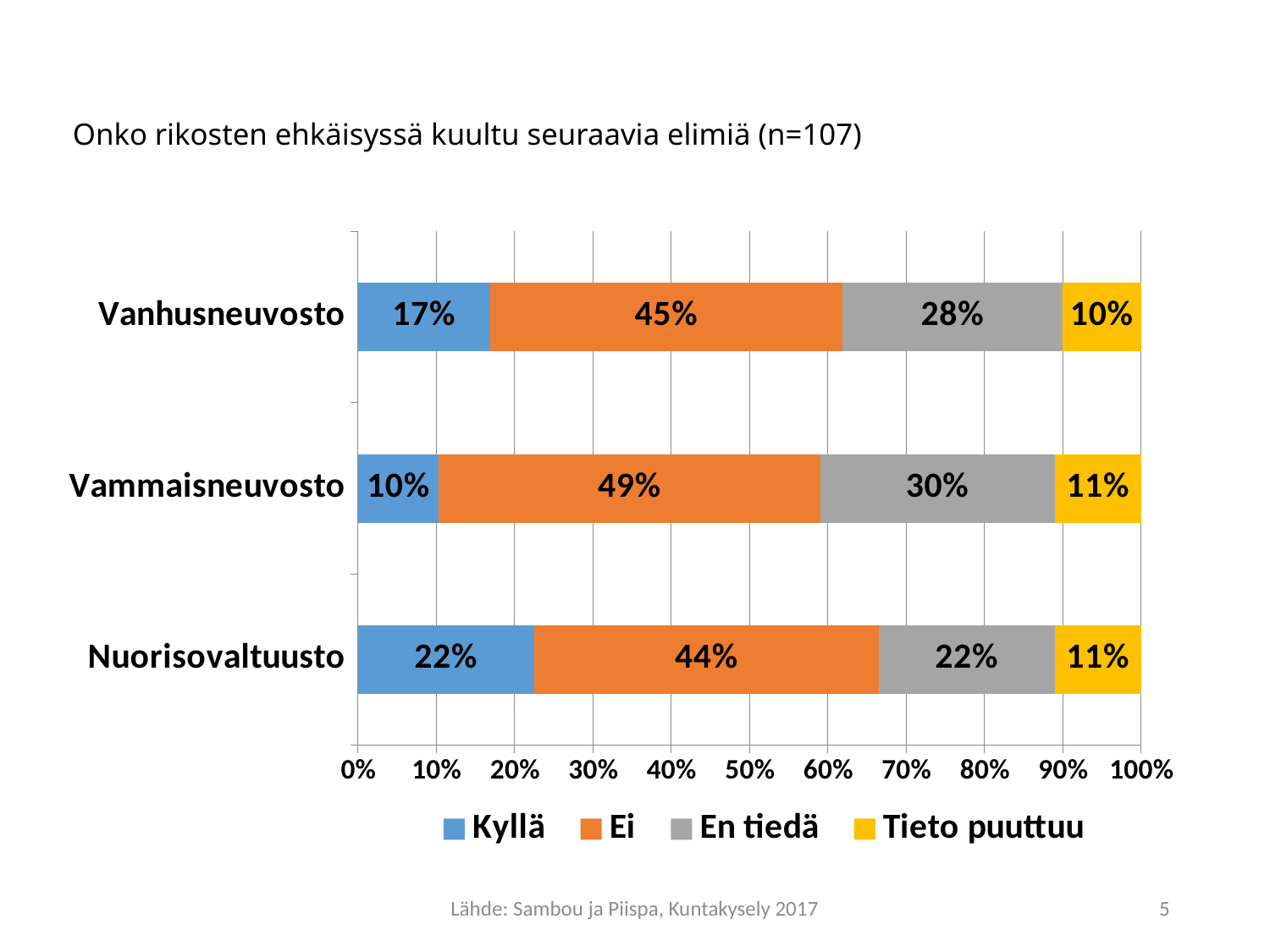
What is the "En tiedä" value for Nuorisovaltuusto? 22% Which category has the highest "Kyllä" value? Nuorisovaltuusto Which series is shown in orange in the legend? Ei What kind of chart is shown on the slide? Stacked bar chart What percentage of respondents answered "Kyllä" for Vanhusneuvosto? 17% What is the "Tieto puuttuu" value for Vanhusneuvosto? 10% How many series does the legend list? 4 What is the difference between the "Ei" values for Vammaisneuvosto and Nuorisovaltuusto? 5% What is the "Ei" value for Vammaisneuvosto? 49% Which is larger: the "En tiedä" value for Vammaisneuvosto or for Vanhusneuvosto? Vammaisneuvosto Which category has the lowest "Kyllä" value? Vammaisneuvosto How many categories are shown on the chart? 3